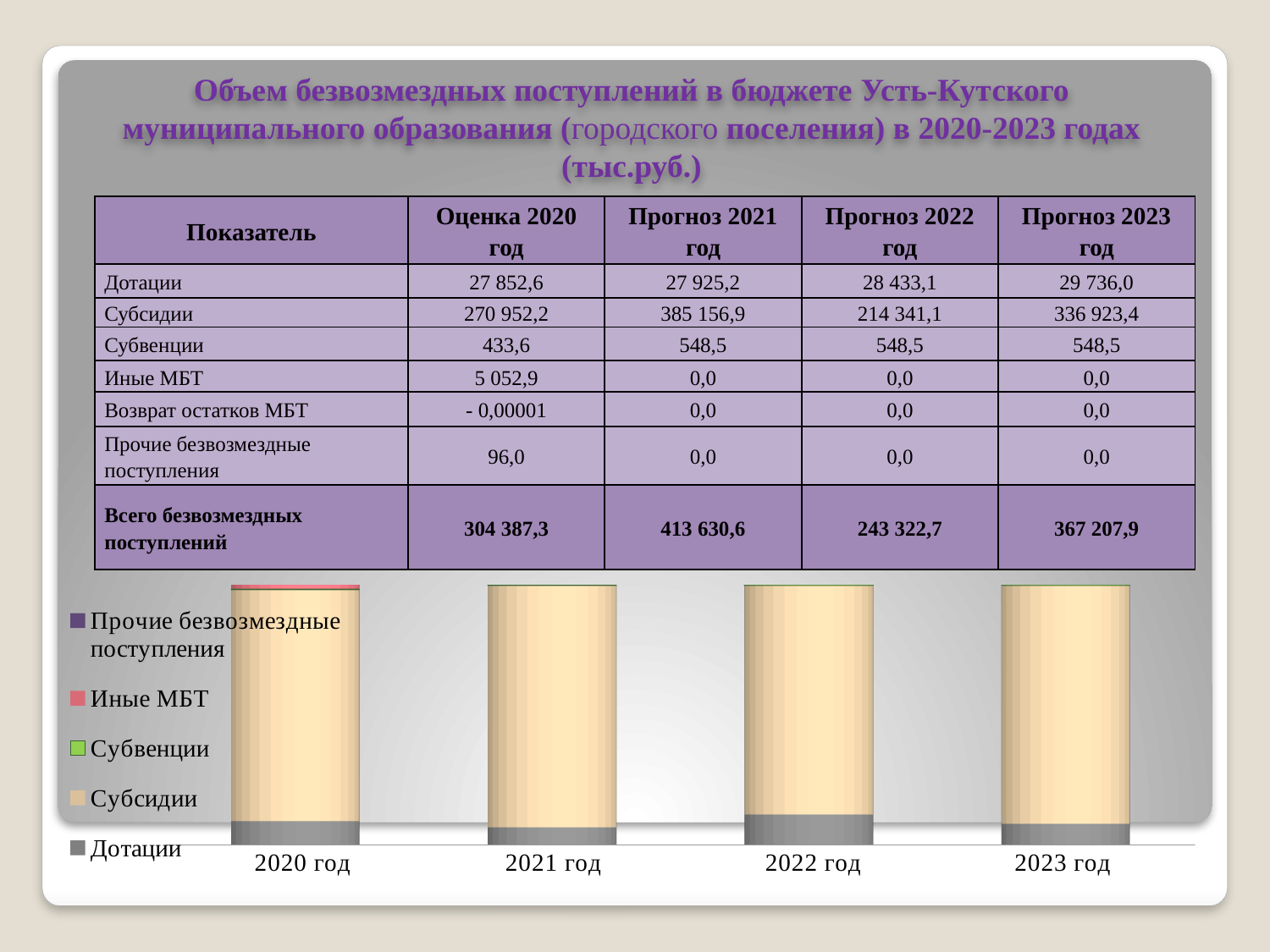
What kind of chart is shown at the bottom of the slide? bar chart According to the table, what is the value of Субсидии for Прогноз 2021 год? 385 156,9 How many series does the chart legend list? 5 How many years (bars) are shown on the x axis of the chart? 4 By how much does the value of Субвенции in Прогноз 2021 год exceed the value in Оценка 2020 год? 114,9 Which is larger: Субсидии in Оценка 2020 год or Субсидии in Прогноз 2022 год? Оценка 2020 год Which series is shown in the light beige colour that makes up most of each bar? Субсидии According to the table, what is the value of Дотации for Прогноз 2023 год? 29 736,0 Do the values of Дотации rise or fall from 2020 to 2023 in the table? rise Which year has the lowest total of Всего безвозмездных поступлений in the table? Прогноз 2022 год Which series forms the bottom (grey) segment of each bar in the chart? Дотации Which year has the highest total of Всего безвозмездных поступлений in the table? Прогноз 2021 год